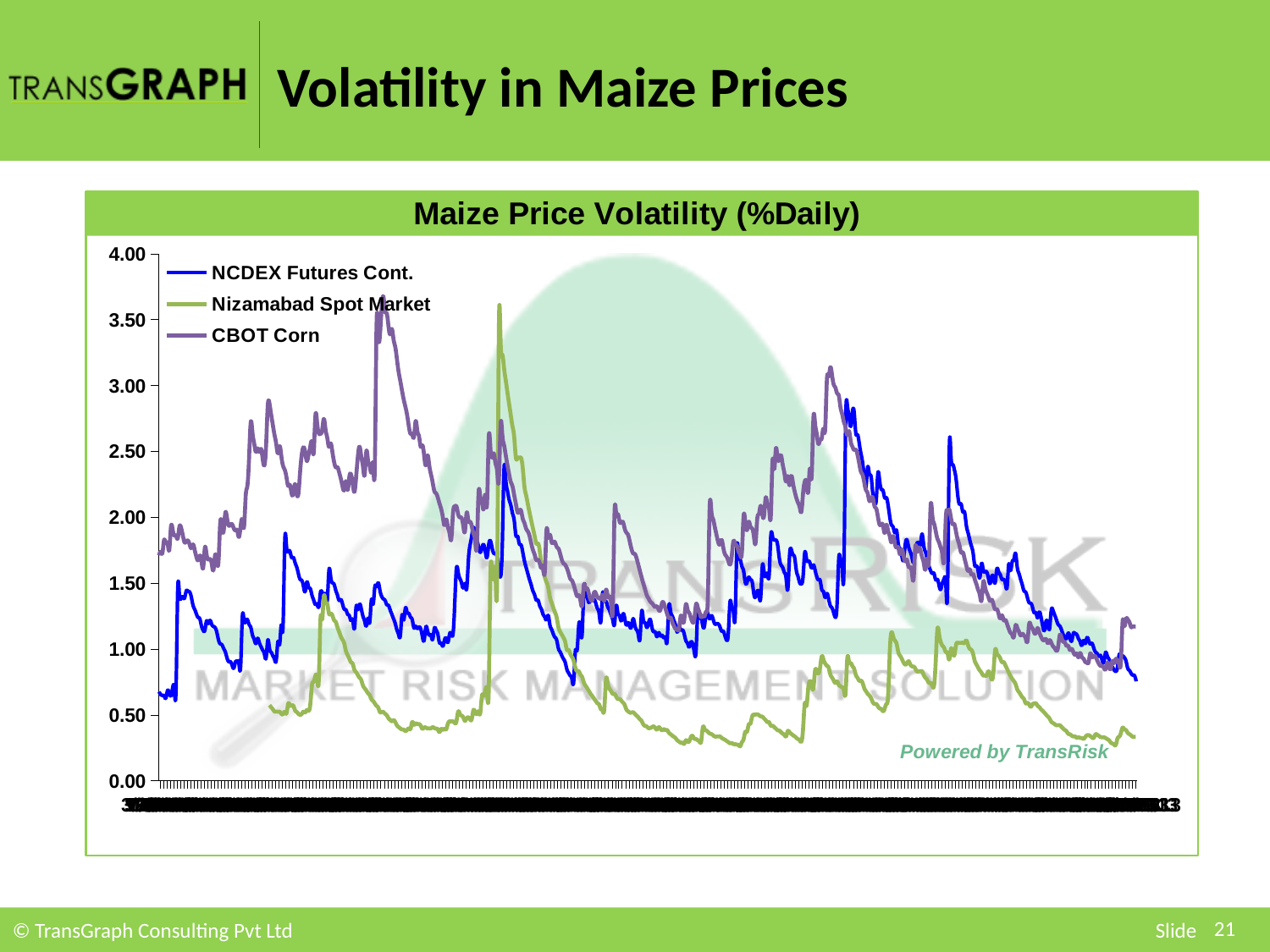
What is the title of the chart? Maize Price Volatility (%Daily) What kind of chart is shown on the slide? line chart How many series does the legend of the Maize Price Volatility chart list? 3 At the left-hand start of the chart, which series is higher: CBOT Corn or NCDEX Futures Cont.? CBOT Corn Which series has the lowest values at the right-hand end of the chart? Nizamabad Spot Market Is the highest peak of the NCDEX Futures Cont. series greater or less than 3.00? less At the right-hand end of the chart, is the Nizamabad Spot Market value greater or less than 0.50? less Is the lowest value of the Nizamabad Spot Market series greater or less than 0.50? less Which series is drawn in blue in the chart? NCDEX Futures Cont. What is the highest value shown on the vertical axis of the chart? 4.00 Does the CBOT Corn series generally rise or fall over the last third of the chart? fall